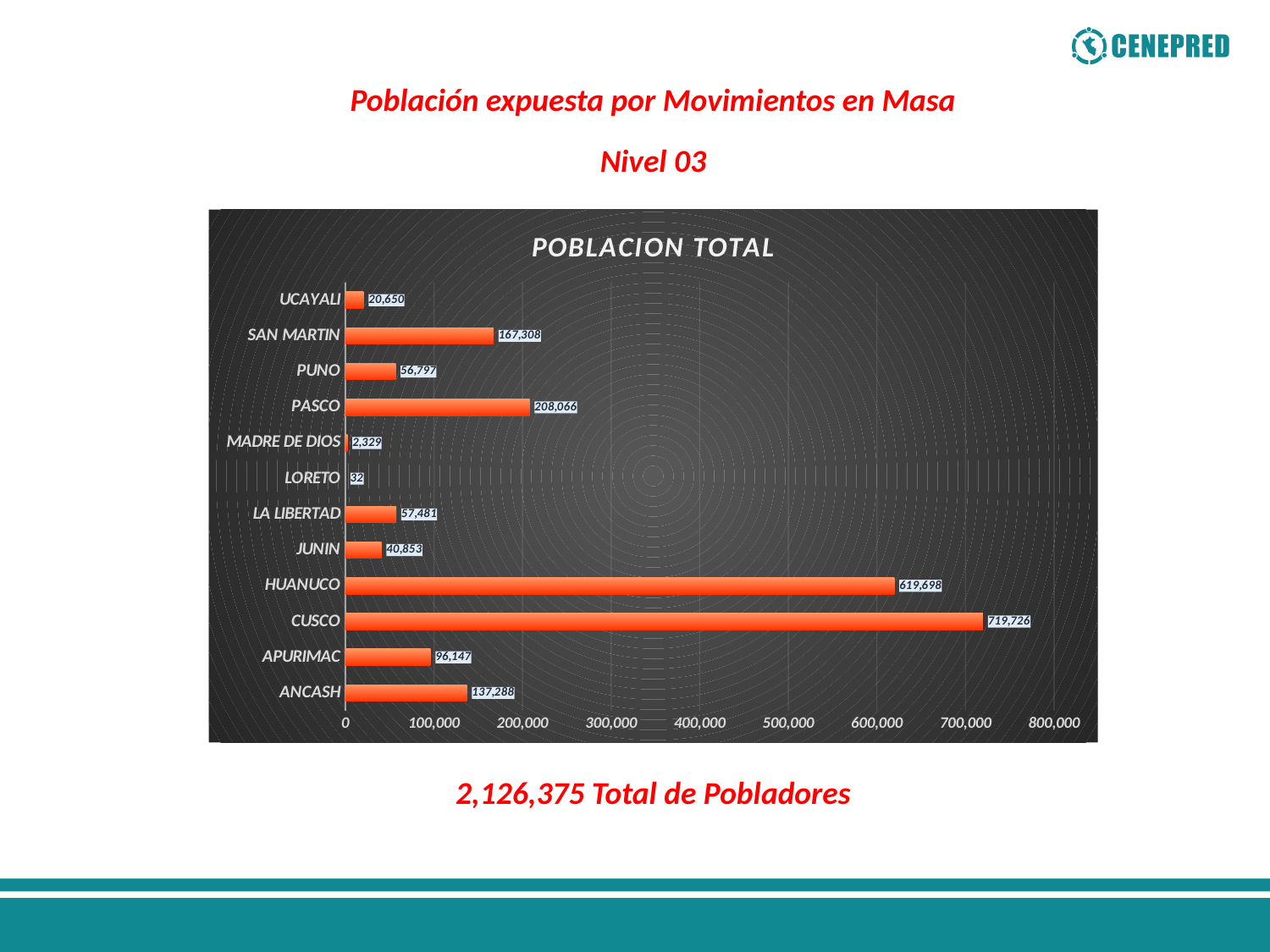
What is the value for ANCASH in the POBLACION TOTAL chart? 137,288 Which category has the highest value in the POBLACION TOTAL chart? CUSCO Which category has the lowest value in the POBLACION TOTAL chart? LORETO Which is larger in the POBLACION TOTAL chart, the value for ANCASH or the value for APURIMAC? ANCASH What is the value for HUANUCO in the POBLACION TOTAL chart? 619,698 What is the title of the chart on the slide? POBLACION TOTAL What is the value for CUSCO in the POBLACION TOTAL chart? 719,726 What kind of chart is the POBLACION TOTAL chart? Bar chart Is the value for SAN MARTIN in the POBLACION TOTAL chart greater or less than 200,000? less How many categories are shown in the POBLACION TOTAL chart? 12 What is the difference between the values for CUSCO and HUANUCO in the POBLACION TOTAL chart? 100,028 What is the value for MADRE DE DIOS in the POBLACION TOTAL chart? 2,329